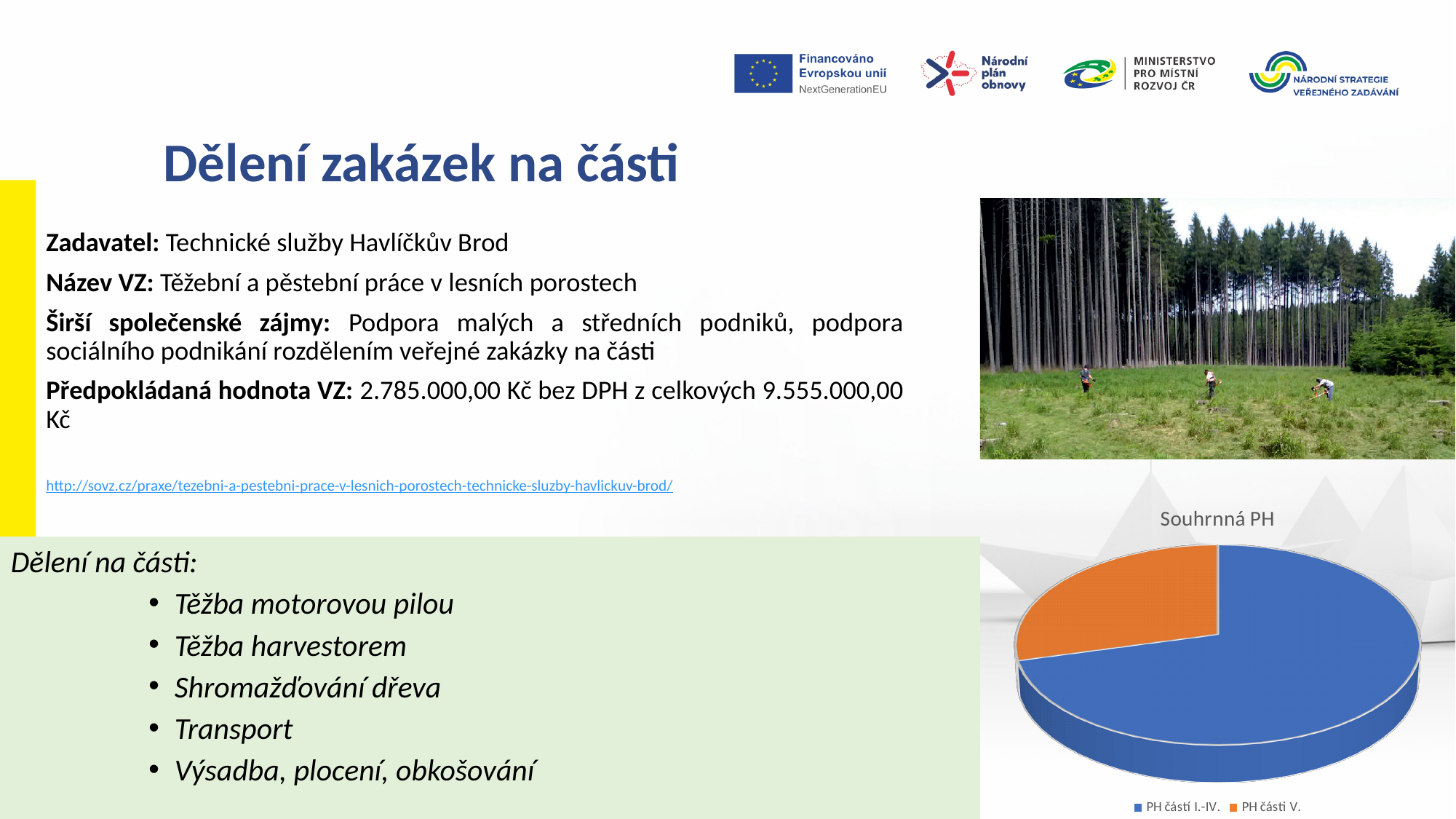
How many slices does the pie chart have? 2 What kind of chart is shown on the slide? pie chart Which slice of the pie chart is the largest? PH částí I.-IV. Which is larger in the pie chart, PH částí I.-IV. or PH části V.? PH částí I.-IV. Which slice of the pie chart is the smallest? PH části V. What is the title of the pie chart? Souhrnná PH How many entries does the legend of the pie chart list? 2 What colour is the slice for PH části V. in the pie chart? orange